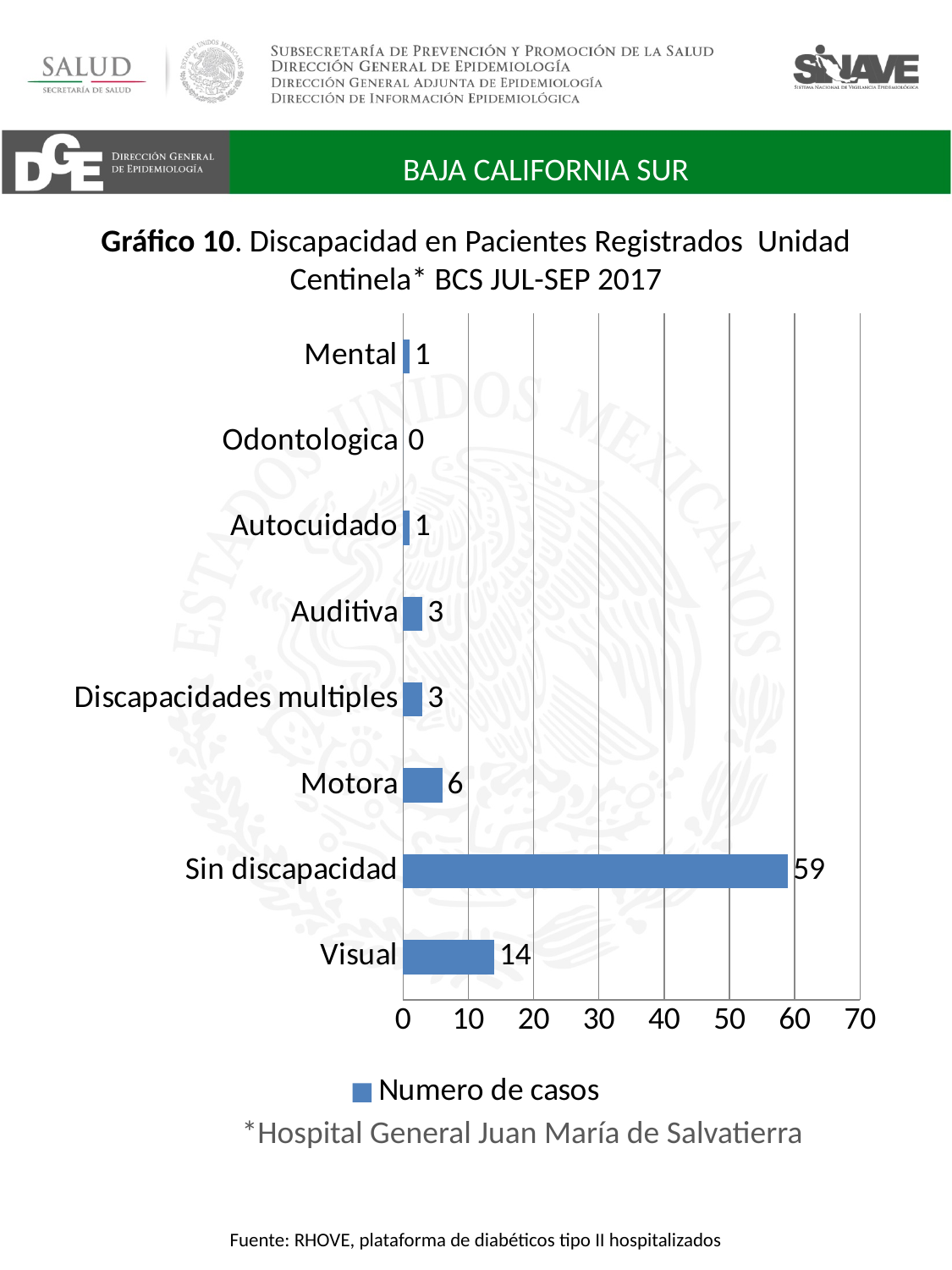
How many series does the legend list? 1 How many categories are shown in the chart? 8 Which has more cases, Motora or Auditiva? Motora Which category has the highest number of cases? Sin discapacidad What is the legend entry of the chart? Numero de casos What kind of chart is shown? bar chart What is the difference between the number of cases for Sin discapacidad and Visual? 45 Is the value for Sin discapacidad greater or less than 50? greater Which category has the lowest number of cases? Odontologica What is the number of cases for Motora? 6 What is the number of cases for Odontologica? 0 What is the number of cases for Visual? 14